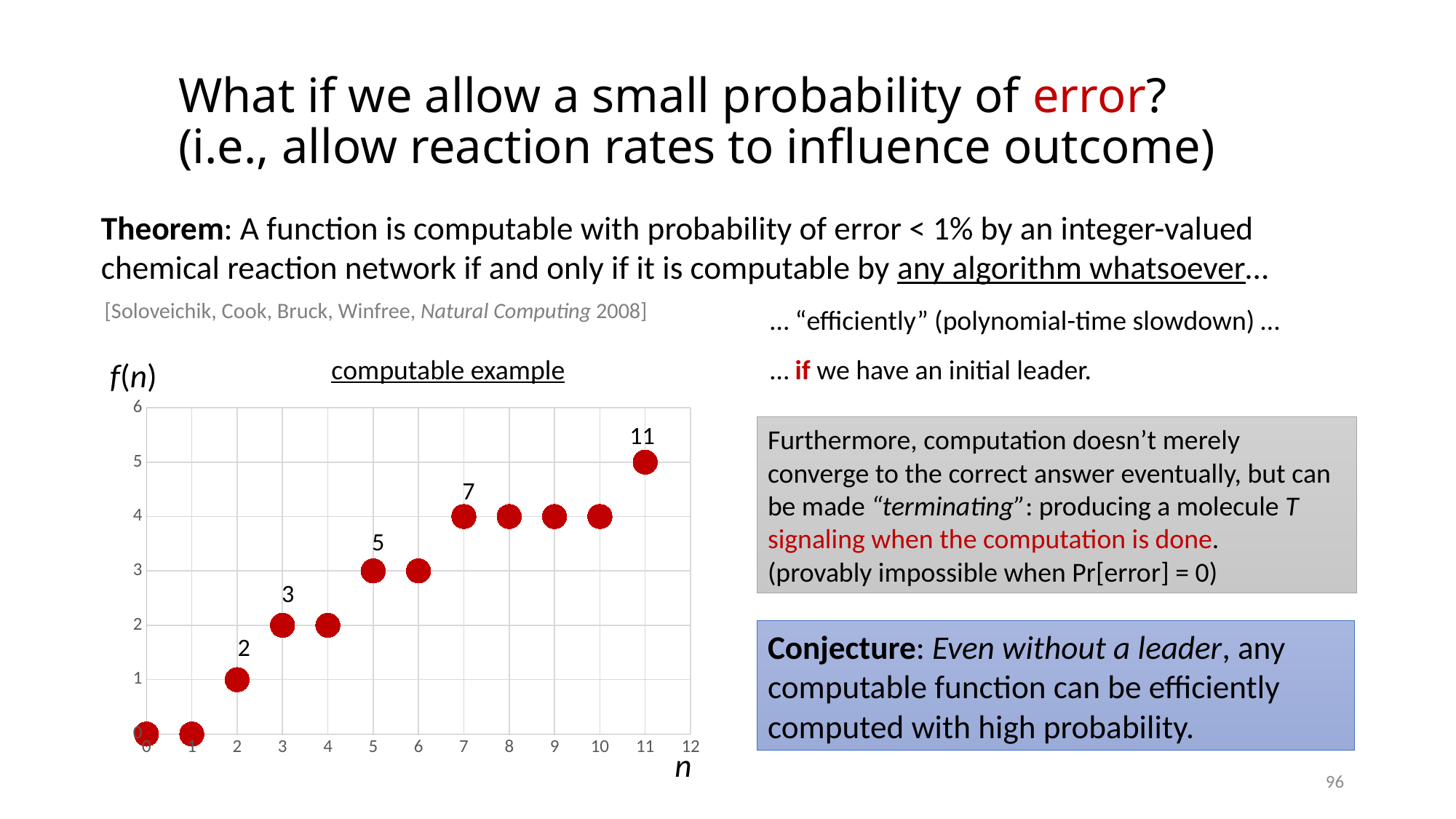
In the "computable example" chart, which is larger, f(5) or f(3)? f(5) How many data points are plotted in the "computable example" chart? 12 In the "computable example" chart, what is the value of f(n) at n = 11? 5 In the "computable example" chart, at which value of n is f(n) highest? 11 In the "computable example" chart, what is the value of f(n) at n = 5? 3 What kind of chart is the "computable example" chart? scatter chart In the "computable example" chart, what is the value of f(n) at n = 2? 1 In the "computable example" chart, what is the lowest plotted value of f(n)? 0 In the "computable example" chart, what is the value of f(n) at n = 7? 4 In the "computable example" chart, what is the difference between f(11) and f(7)? 1 In the "computable example" chart, what data label is printed above the point at n = 11? 11 In the "computable example" chart, do the values of f(n) generally rise or fall as n increases? rise